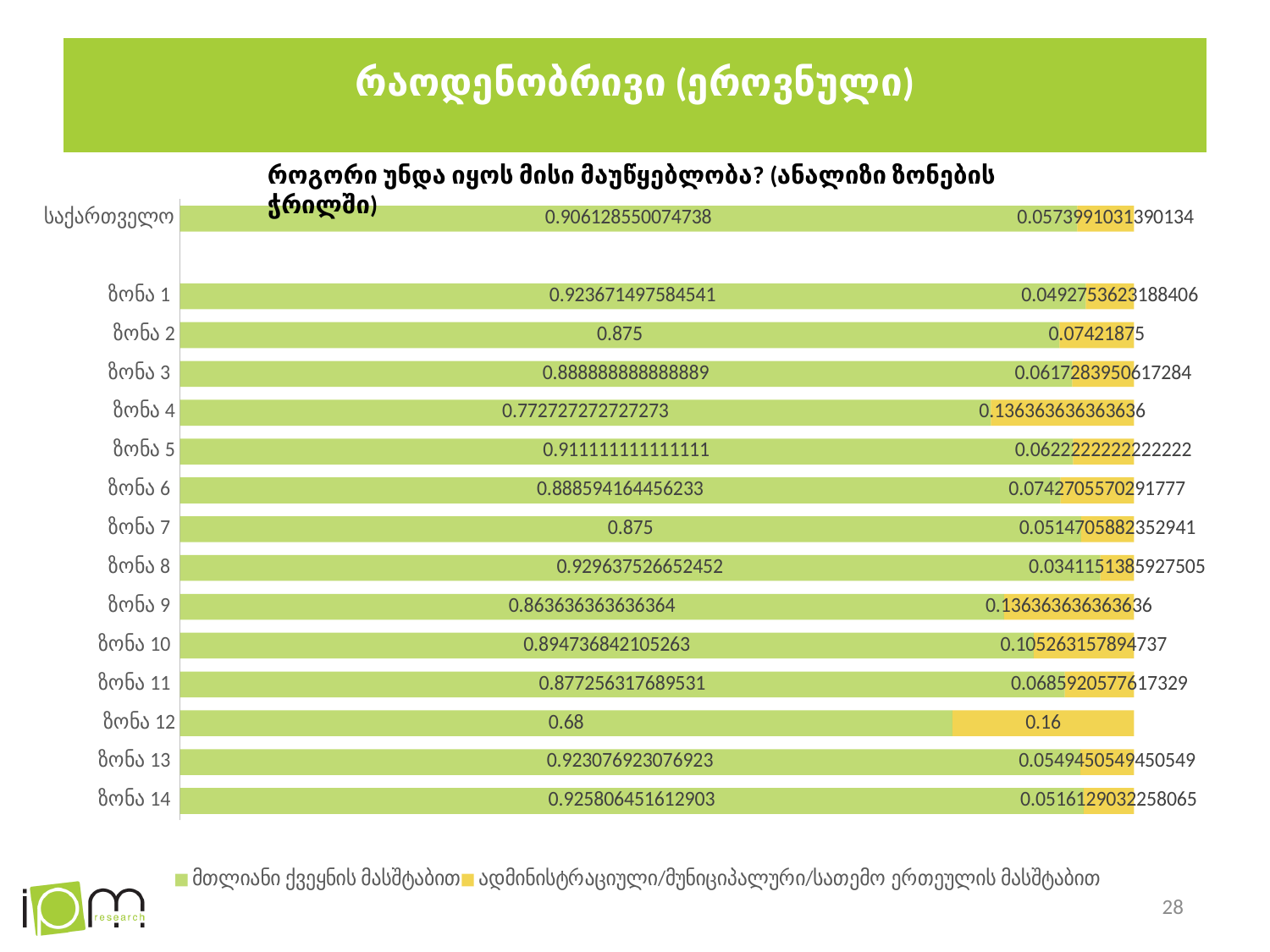
What is the total of the two stacked segments for ზონა 12? 0.84 What is the value of the green series for ზონა 2? 0.875 Which category has the lowest value in the green series (მთლიანი ქვეყნის მასშტაბით)? ზონა 12 How many categories are shown on the chart? 15 What is the value of the green series for საქართველო? 0.906128550074738 What is the difference between the green and yellow values for ზონა 12? 0.52 What is the value of the yellow series (ადმინისტრაციული/მუნიციპალური/სათემო ერთეულის მასშტაბით) for ზონა 12? 0.16 Which category has the highest value in the green series (მთლიანი ქვეყნის მასშტაბით)? ზონა 8 Which has a larger green-series value, ზონა 4 or ზონა 12? ზონა 4 How many series does the legend list? 2 What is the value of the green series (მთლიანი ქვეყნის მასშტაბით) for ზონა 12? 0.68 Which category has the highest value in the yellow series (ადმინისტრაციული/მუნიციპალური/სათემო ერთეულის მასშტაბით)? ზონა 12